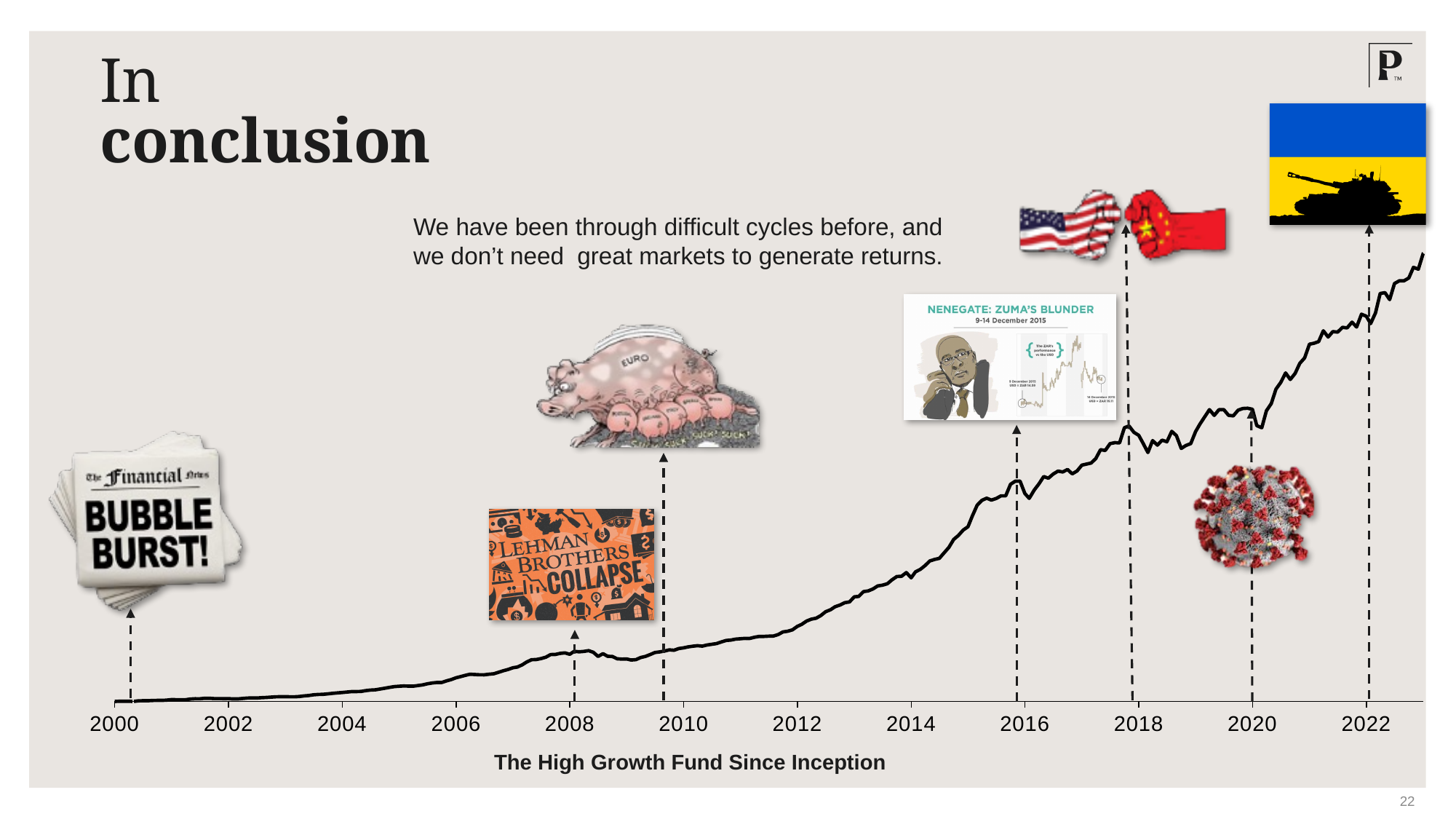
What is the interval between consecutive year labels on the x axis? 2 years What is the title of the chart? The High Growth Fund Since Inception What kind of chart is shown on the slide? line chart Is the value of the line higher in 2018 or in 2010? 2018 Is the value of the line higher in 2022 or in 2000? 2022 How many series are plotted in the chart? 1 Does the line in the chart generally rise or fall from 2000 to 2022? rise Around which labelled year on the x axis is the line at its highest? 2022 Around which labelled year on the x axis is the line at its lowest? 2000 Is the value of the line higher in 2014 or in 2006? 2014 How many year labels are shown on the x axis of the chart? 12 What is the first year labelled on the x axis of the chart? 2000